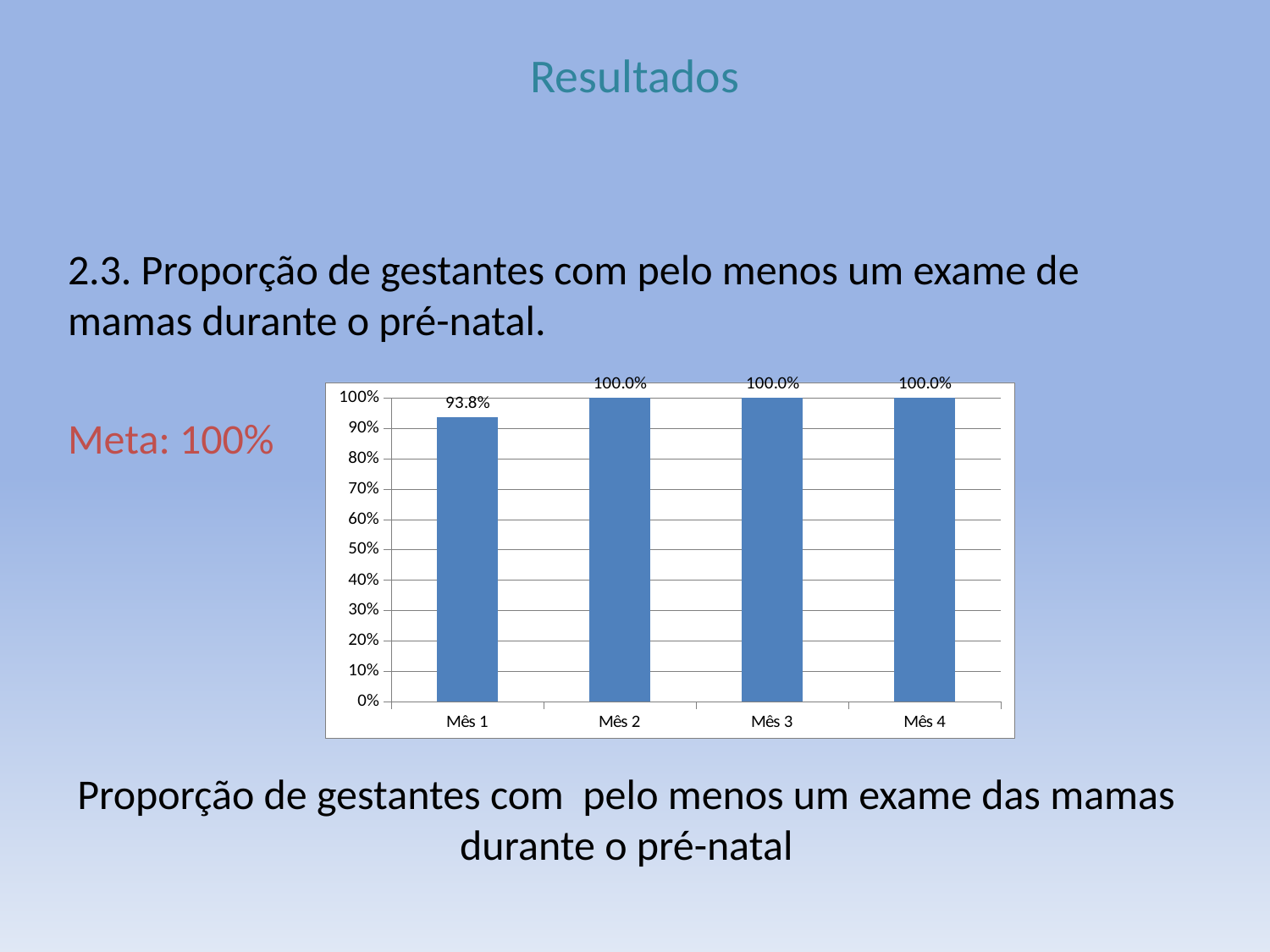
What kind of chart is shown on the slide? bar chart Is the value for Mês 1 greater or less than 90%? greater What is the value for Mês 1? 93.8% What is the value for Mês 2? 100.0% Which is larger, the value for Mês 1 or the value for Mês 3? Mês 3 What is the difference between the values for Mês 2 and Mês 1? 6.2% Do the values rise or fall from Mês 1 to Mês 2? rise What is the target (Meta) stated on the slide for this indicator? 100% How many months are shown on the x axis? 4 Which month has the lowest value? Mês 1 What is the value for Mês 4? 100.0% How many months reach the 100.0% value? 3